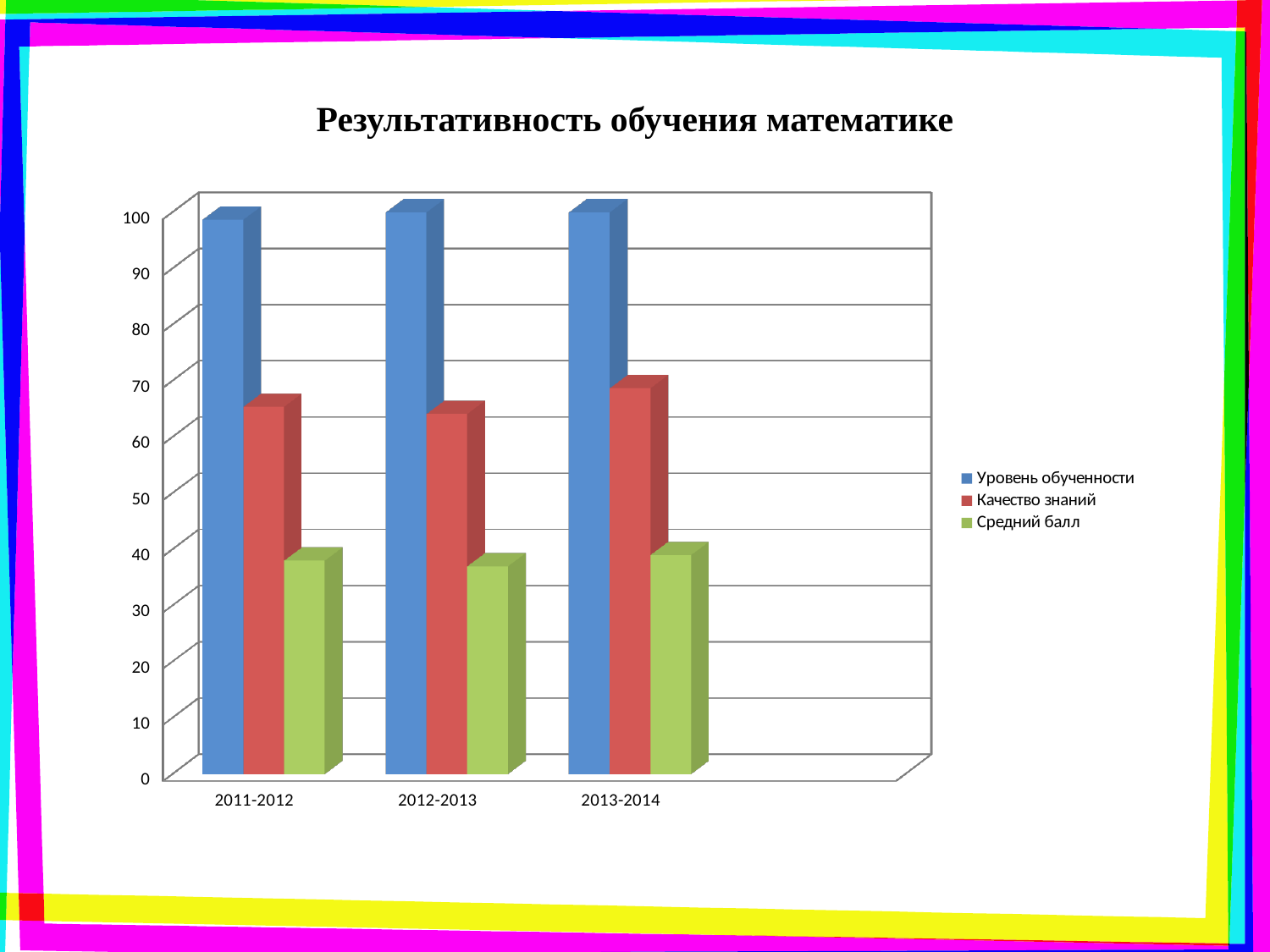
Is the value for Качество знаний in 2011-2012 greater or less than 60? greater How many series does the legend list? 3 What is the title of the chart? Результативность обучения математике Is the value for Уровень обученности in 2011-2012 greater or less than 90? greater Which series has the lowest value in 2011-2012? Средний балл Which series has the highest value in 2013-2014? Уровень обученности What kind of chart is shown on the slide? bar chart Which series is shown in blue in the legend? Уровень обученности Is the value for Средний балл in 2013-2014 greater or less than 30? greater How many categories (school years) are shown on the x axis? 3